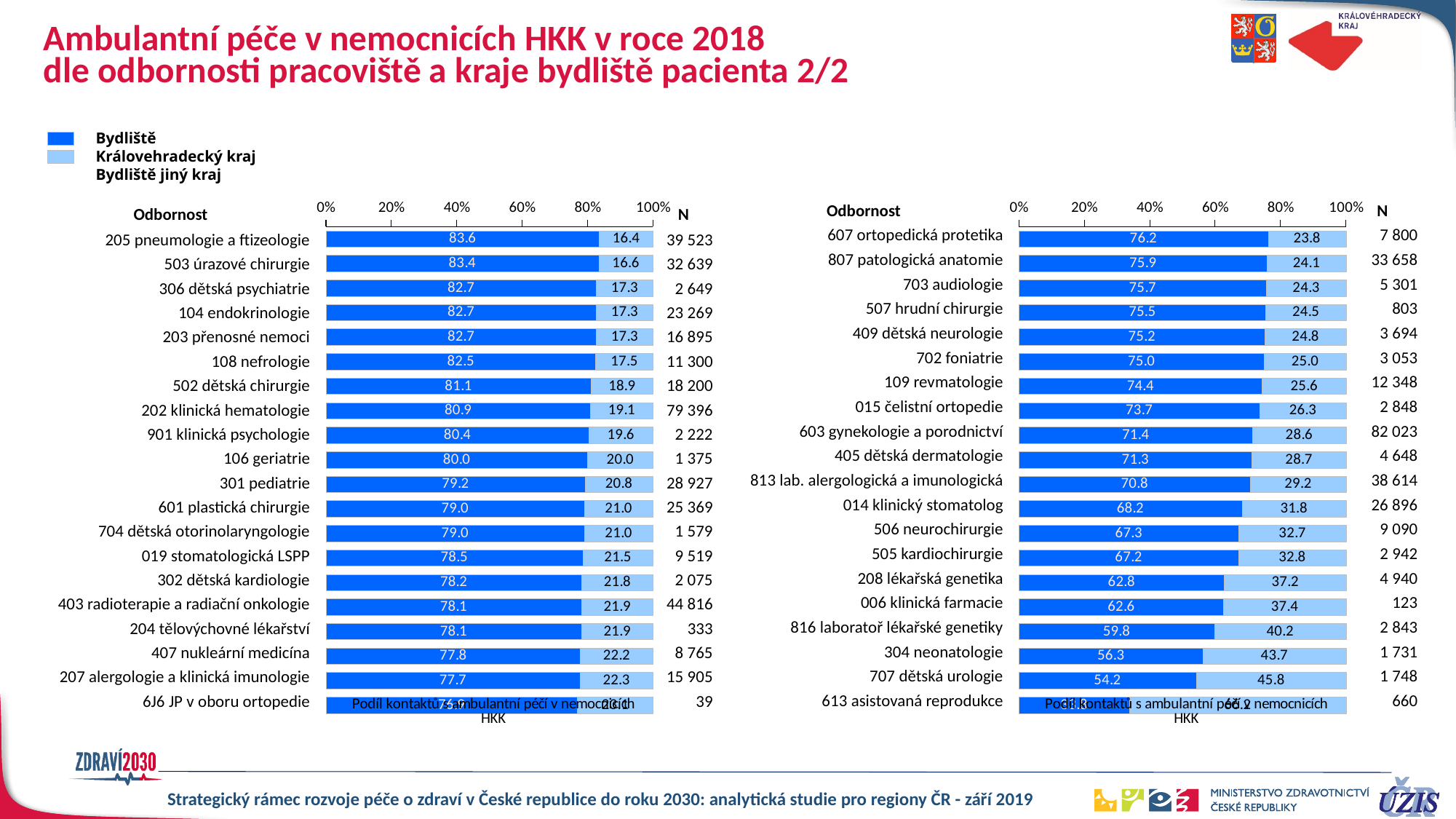
On the right chart, what is the total of the stacked bar for 506 neurochirurgie? 100.0 On the right chart, what is the difference between the Bydliště jiný kraj values for 707 dětská urologie and 607 ortopedická protetika? 22.0 How many series does the legend list? 2 On the right chart, what is the value for Bydliště jiný kraj for 208 lékařská genetika? 37.2 What type of chart is used on the slide? Stacked bar chart On the left chart, what is the value for Bydliště jiný kraj for 106 geriatrie? 20.0 On the left chart, which is larger: the Bydliště Královehradecký kraj value for 502 dětská chirurgie or for 301 pediatrie? 502 dětská chirurgie On the left chart, what is the value for Bydliště Královehradecký kraj for 205 pneumologie a ftizeologie? 83.6 On the left chart, which category has the highest Bydliště Královehradecký kraj share? 205 pneumologie a ftizeologie On the right chart, what is the N value shown for 603 gynekologie a porodnictví? 82 023 On the right chart, what is the value for Bydliště Královehradecký kraj for 304 neonatologie? 56.3